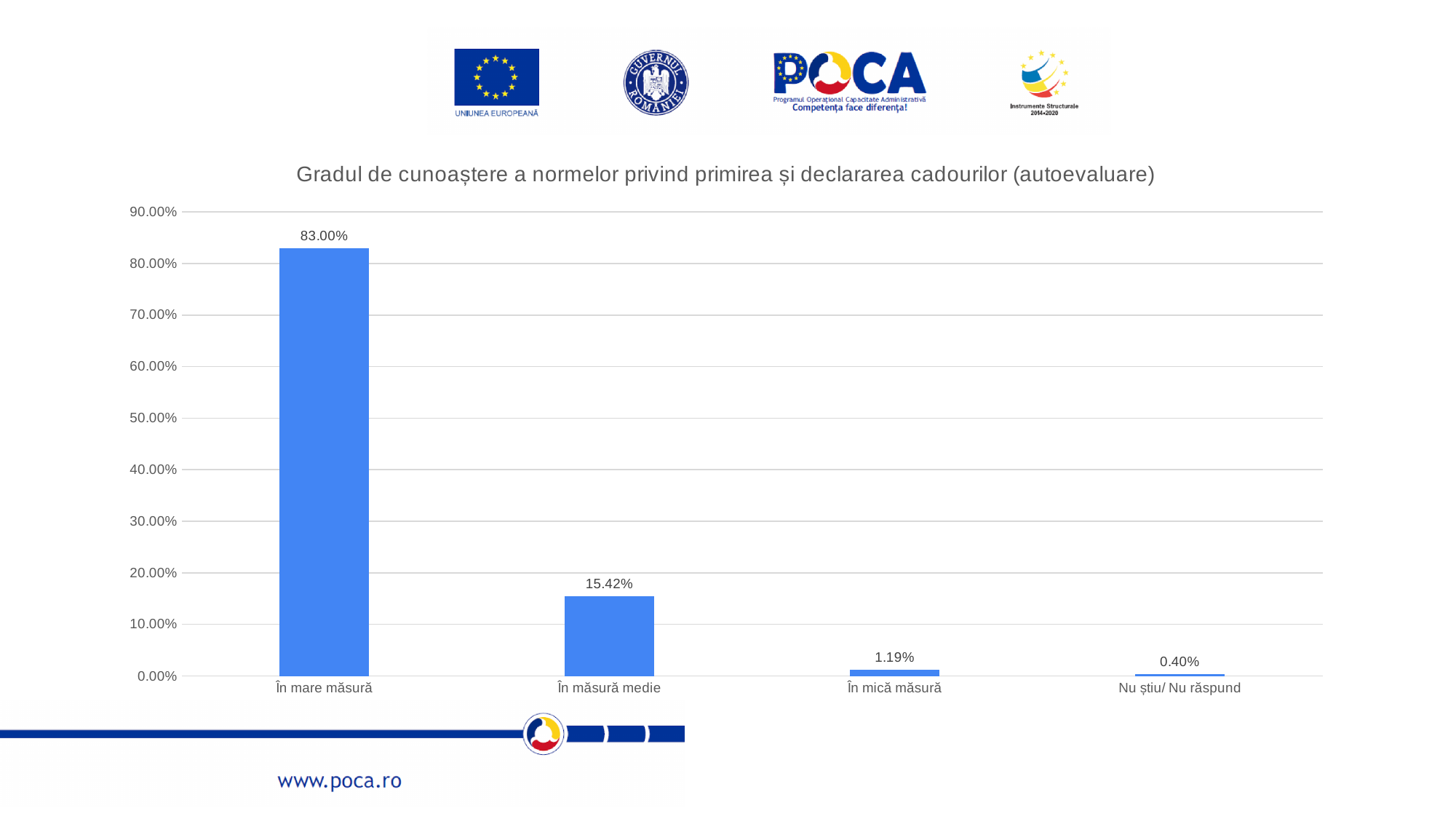
What is the difference between the values for "În mare măsură" and "În măsură medie"? 67.58% Which category has the highest value? În mare măsură What is the value for "Nu știu/ Nu răspund"? 0.40% Which category has the lowest value? Nu știu/ Nu răspund Which is larger, the value for "În mică măsură" or the value for "Nu știu/ Nu răspund"? În mică măsură How many categories are shown on the x axis? 4 What is the title of the chart? Gradul de cunoaștere a normelor privind primirea și declararea cadourilor (autoevaluare) Is the value for "În măsură medie" greater or less than 20.00%? less What is the value for "În măsură medie"? 15.42% What is the value for "În mare măsură"? 83.00% What is the value for "În mică măsură"? 1.19% What kind of chart is shown on the slide? bar chart